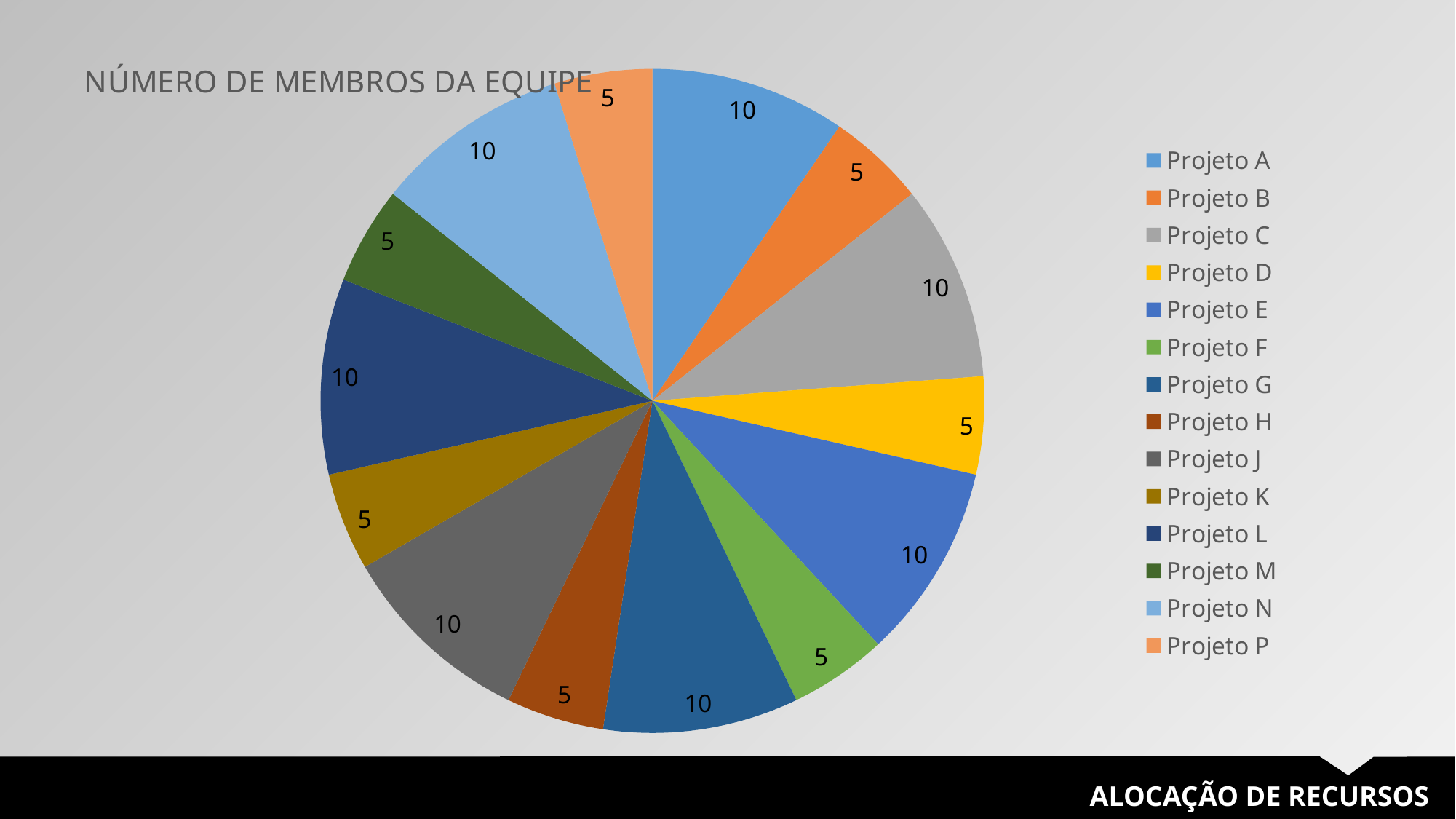
What is the value for Projeto P? 5 What is the value for Projeto D? 5 What kind of chart is shown on the slide? pie chart What is the total of all the slice values in the pie chart? 105 How many projects (slices) does the pie chart show? 14 What is the title of the chart? NÚMERO DE MEMBROS DA EQUIPE Which legend entry is listed last in the legend? Projeto P What is the value for Projeto G? 10 What is the difference between the value for Projeto L and the value for Projeto M? 5 Which is larger, the value for Projeto C or the value for Projeto H? Projeto C What is the value for Projeto B? 5 What is the value for Projeto A? 10